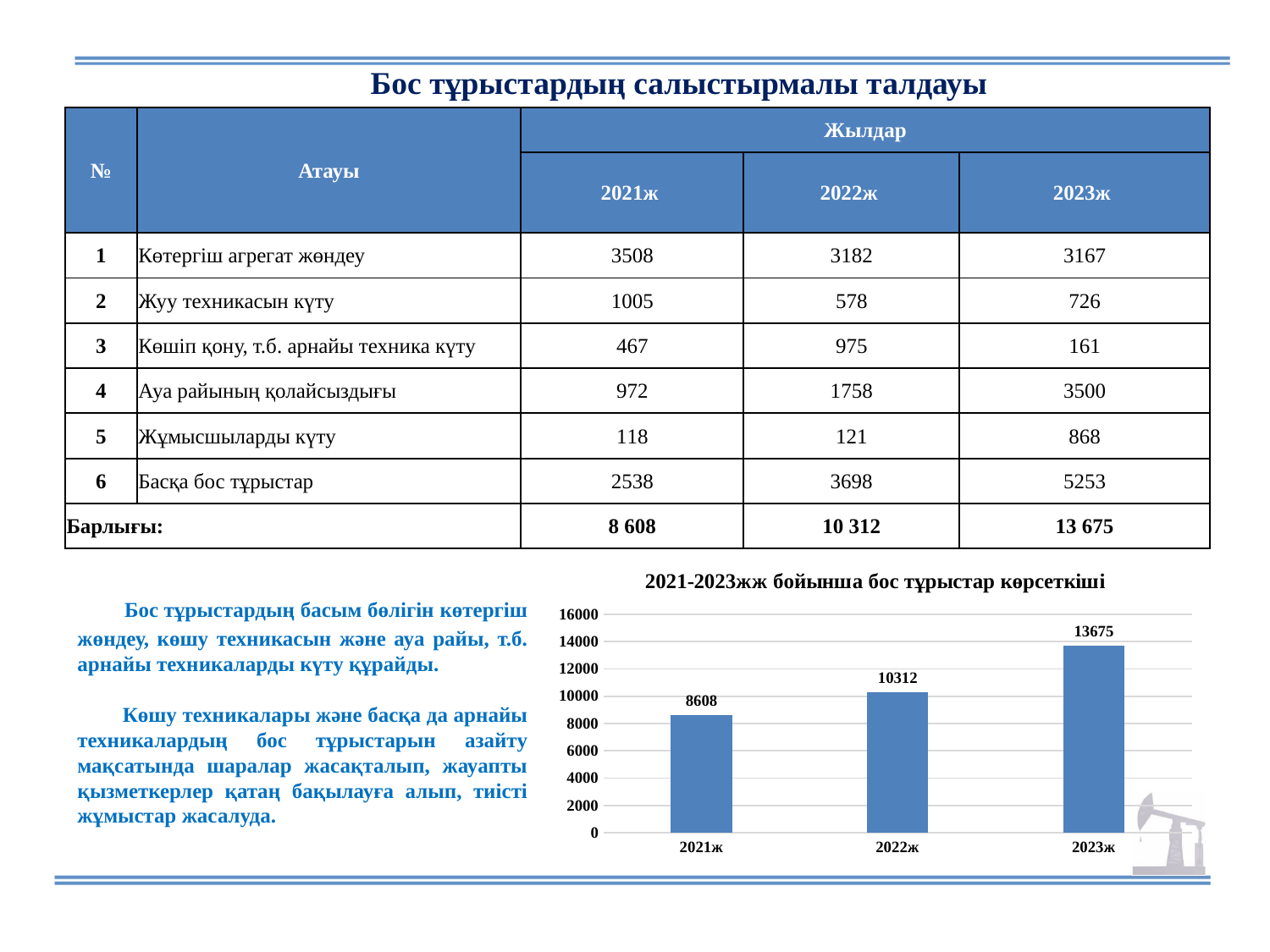
What is the value for 2023ж in the chart? 13675 Which is larger in the chart, the value for 2021ж or the value for 2022ж? 2022ж What kind of chart is shown on the slide? bar chart Which year has the highest value in the chart? 2023ж Which year has the lowest value in the chart? 2021ж What is the difference between the values for 2022ж and 2021ж in the chart? 1704 What is the difference between the values for 2023ж and 2022ж in the chart? 3363 Do the values in the chart rise or fall from 2021ж to 2023ж? rise What is the value for 2022ж in the chart? 10312 How many bars are shown in the chart? 3 What is the value for 2021ж in the chart? 8608 Is the value for 2023ж in the chart greater or less than 12000? greater